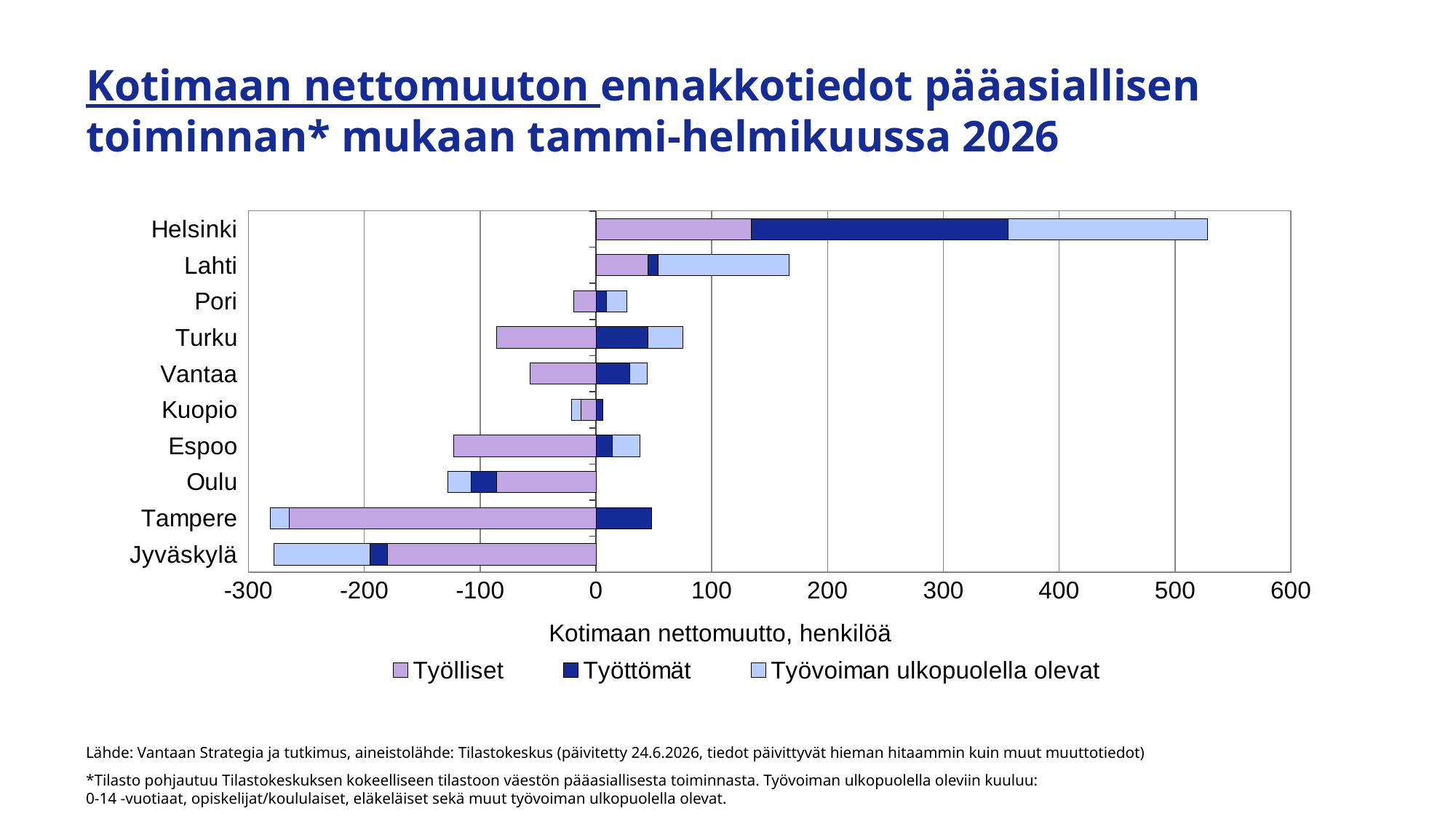
Is the Työlliset value for Tampere greater or less than -200? less How many series does the chart legend list? 3 Which series is shown in dark blue in the chart legend? Työttömät What is the label of the horizontal axis of the chart? Kotimaan nettomuutto, henkilöä How many cities are listed on the vertical axis of the chart? 10 What kind of chart is shown on the slide? Stacked horizontal bar chart Is the Työlliset value for Helsinki greater or less than 100? greater Is the Työttömät value for Helsinki greater or less than 200? greater Which city has the largest Työttömät (dark blue) segment in the chart? Helsinki Which city has the most negative Työlliset (light purple) segment in the chart? Tampere Which is larger, the Työttömät value for Helsinki or the Työttömät value for Lahti? Helsinki